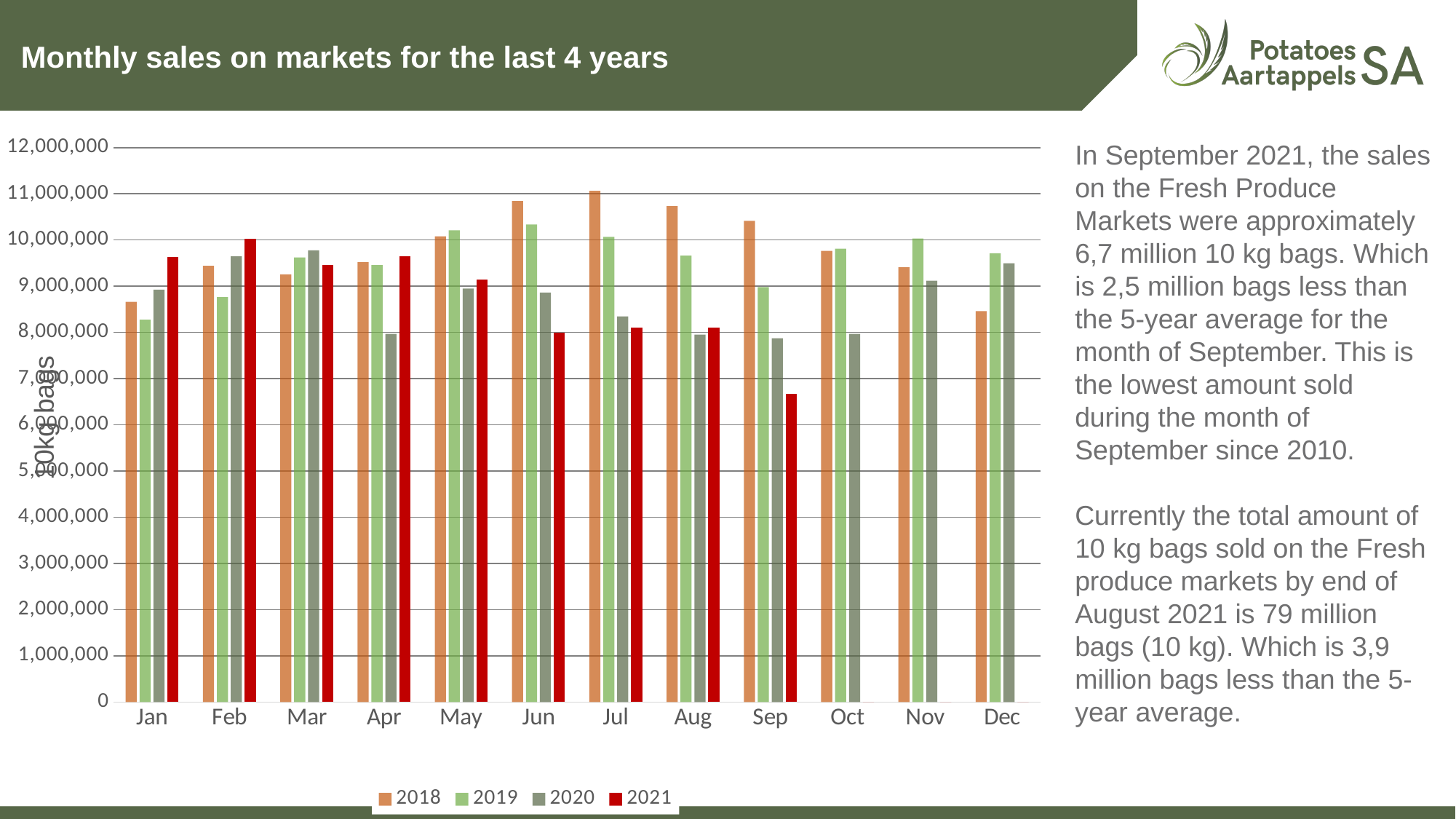
What kind of chart is shown on the slide? Bar chart How many series does the legend list? 4 In Sep, which is larger: the 2018 value or the 2021 value? 2018 Do the 2018 values rise or fall from Jul to Dec? fall In Jan, which is larger: the 2018 value or the 2021 value? 2021 In which month is the 2018 bar the highest? Jul Is the value for 2021 in Sep greater or less than 7,000,000? less How many months have a bar for 2021? 9 In which month is the 2021 bar the lowest? Sep How many months are shown on the x axis? 12 Is the value for 2018 in Jul greater or less than 10,000,000? greater Is the value for 2021 in Jun greater or less than 9,000,000? less